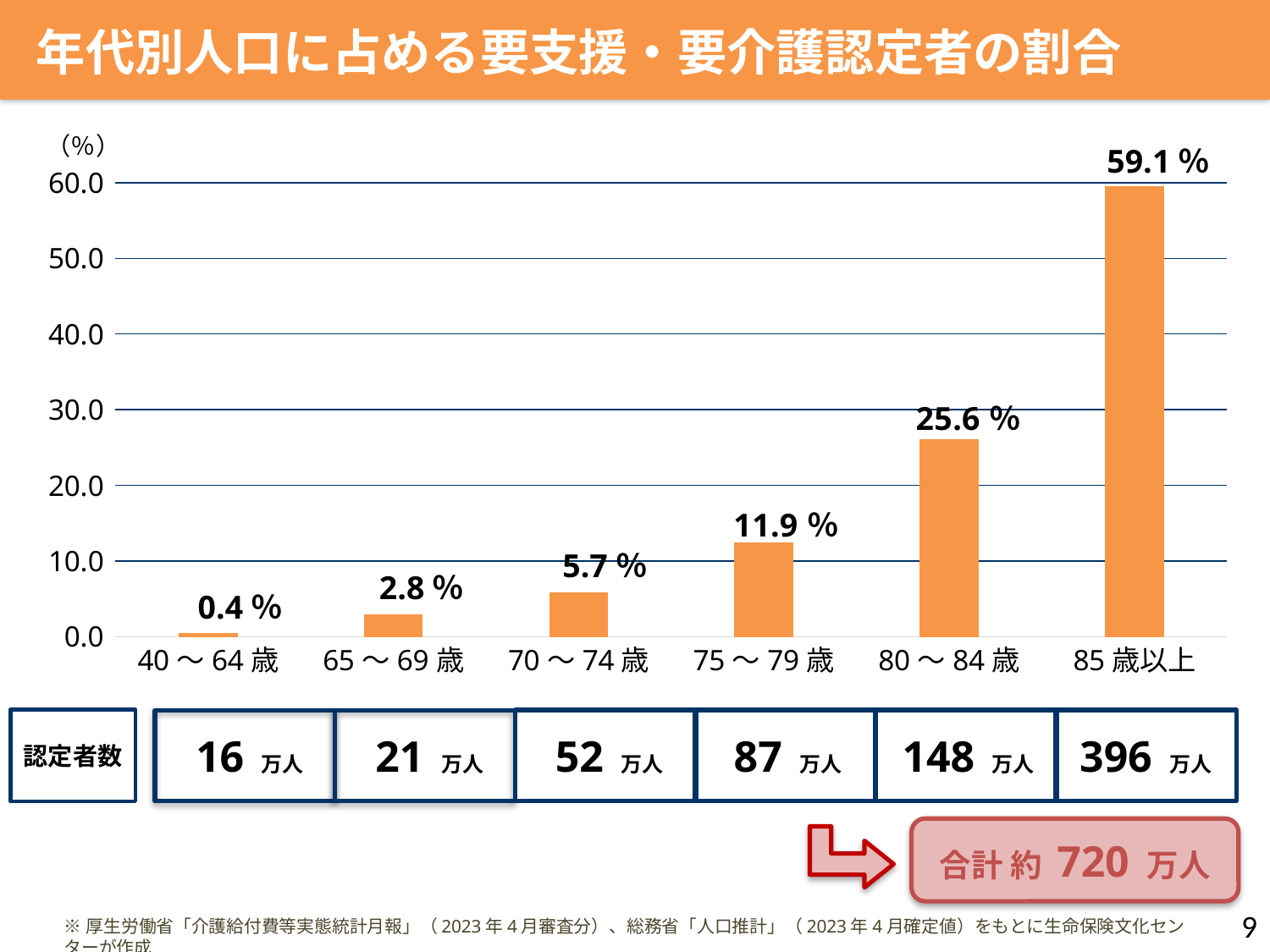
What is the value for 75～79歳? 11.9 % Which age group has the highest value? 85歳以上 What is the value for 85歳以上? 59.1 % What is the value for 40～64歳? 0.4 % What is the difference between the values for 75～79歳 and 70～74歳? 6.2 % Which age group has the lowest value? 40～64歳 Is the value for 80～84歳 greater or less than 20.0? greater Which is larger, the value for 65～69歳 or the value for 70～74歳? 70～74歳 How many age groups are shown in the chart? 6 What is the difference between the values for 85歳以上 and 80～84歳? 33.5 % Do the values rise or fall as the age groups move from left to right? rise What kind of chart is shown on the slide? bar chart